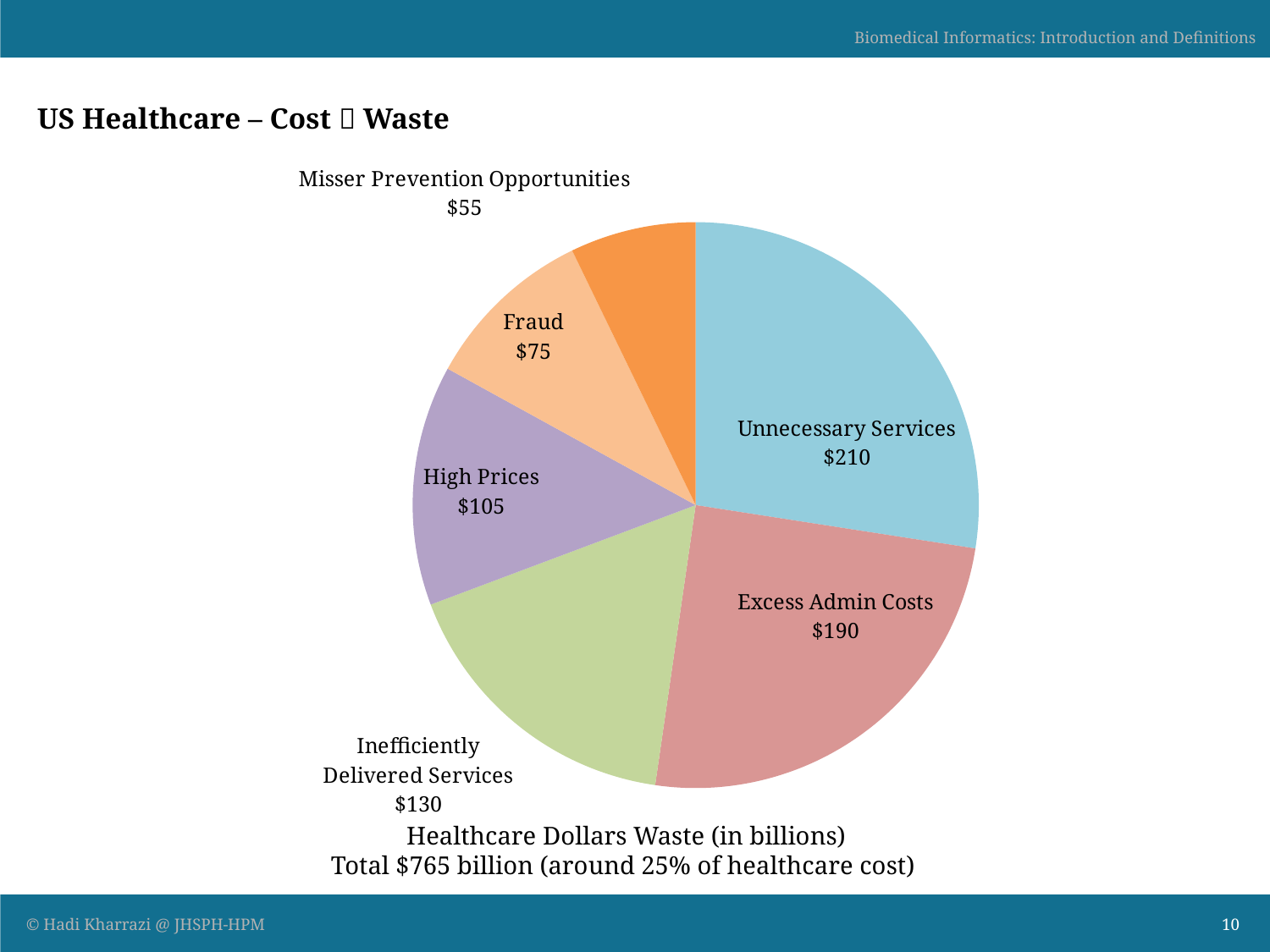
Which category has the smallest slice of the pie? Misser Prevention Opportunities What is the value shown for High Prices? $105 What is the value shown for Fraud? $75 Which category has the largest slice of the pie? Unnecessary Services What kind of chart is shown on the slide? Pie chart What is the value shown for Excess Admin Costs? $190 What is the value shown for Unnecessary Services? $210 What total is stated for healthcare dollars wasted? $765 billion What is the caption below the pie chart that states the unit of the values? Healthcare Dollars Waste (in billions) What is the difference between the values for Unnecessary Services and Excess Admin Costs? $20 Which is larger, Inefficiently Delivered Services or High Prices? Inefficiently Delivered Services How many slices does the pie chart have? 6